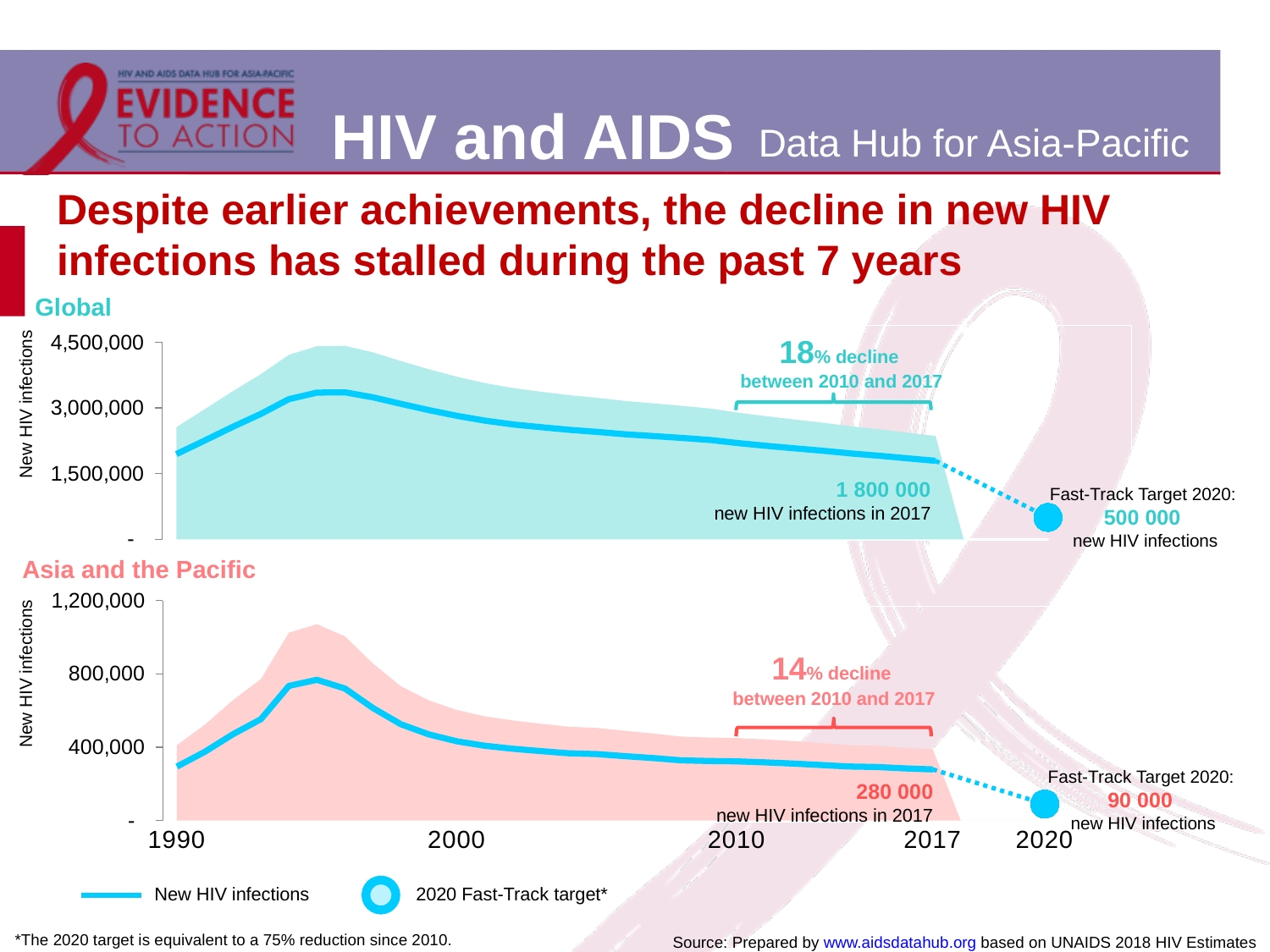
On the Asia and the Pacific chart, what percentage decline in new HIV infections is shown between 2010 and 2017? 14% What kind of chart is the Global chart? combination area and line chart On the Asia and the Pacific chart, is the value for new HIV infections in 1990 greater or less than 400,000? less On the Asia and the Pacific chart, how many new HIV infections were there in 2017? 280 000 On the Global chart, what is the Fast-Track Target 2020 for new HIV infections? 500 000 Which chart shows a larger percentage decline between 2010 and 2017, Global or Asia and the Pacific? Global On the Asia and the Pacific chart, what is the Fast-Track Target 2020 for new HIV infections? 90 000 On the Global chart, how many new HIV infections were there in 2017? 1 800 000 On the Global chart, is the value for new HIV infections in 1990 greater or less than 1,500,000? greater On the Global chart, what is the difference between new HIV infections in 2017 and the Fast-Track Target 2020? 1 300 000 On the Global chart, what percentage decline in new HIV infections is shown between 2010 and 2017? 18% On the Asia and the Pacific chart, what is the difference between new HIV infections in 2017 and the Fast-Track Target 2020? 190 000